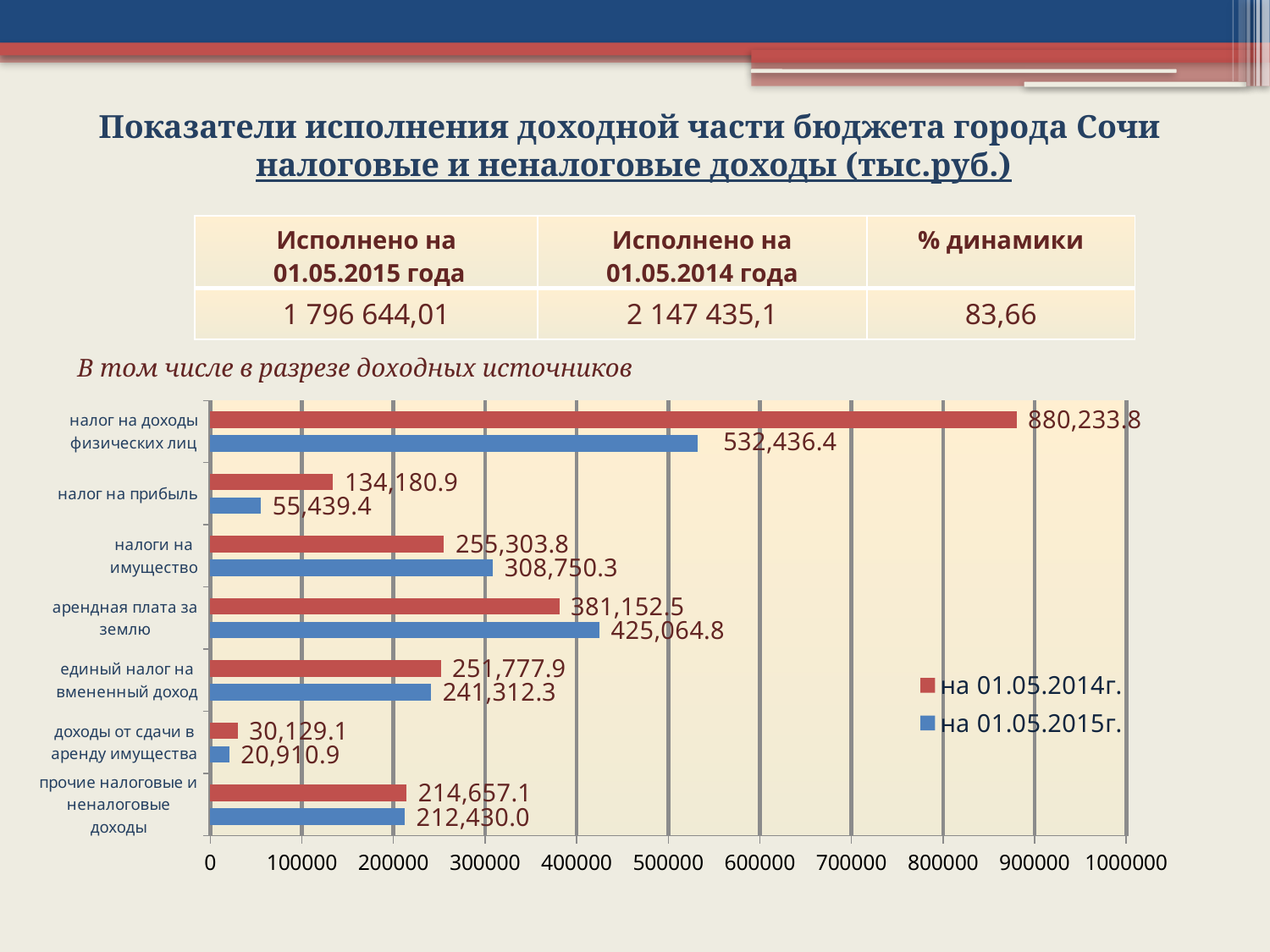
What kind of chart is shown on the slide? bar chart For арендная плата за землю, which series has the larger value: на 01.05.2014г. or на 01.05.2015г.? на 01.05.2015г. What is the value for арендная плата за землю in the series на 01.05.2015г.? 425,064.8 Which category has the highest value in the series на 01.05.2014г.? налог на доходы физических лиц What is the value for налог на доходы физических лиц in the series на 01.05.2015г.? 532,436.4 What is the difference between the на 01.05.2014г. and на 01.05.2015г. values for налог на доходы физических лиц? 347,797.4 Is the value for налог на доходы физических лиц in the series на 01.05.2014г. greater or less than 800000? greater How many series does the legend list? 2 What is the value for налог на прибыль in the series на 01.05.2014г.? 134,180.9 Which category has the lowest value in the series на 01.05.2015г.? доходы от сдачи в аренду имущества What is the difference between the на 01.05.2015г. and на 01.05.2014г. values for налоги на имущество? 53,446.5 How many categories are shown on the chart? 7